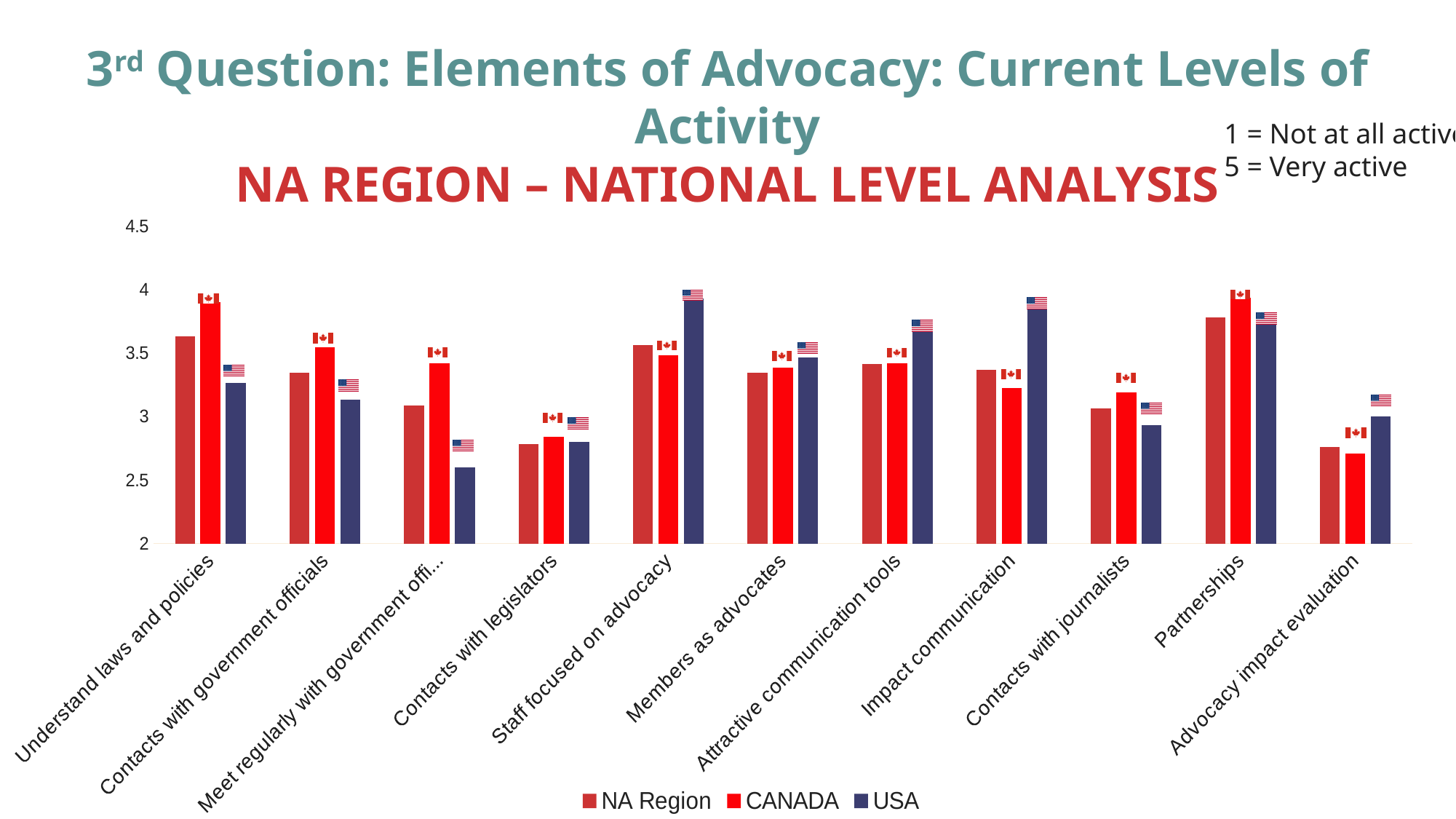
For Impact communication, which is larger: the USA value or the CANADA value? USA How many series does the legend list? 3 Is the USA value for Staff focused on advocacy greater or less than 3.5? greater For Understand laws and policies, which is larger: the CANADA value or the USA value? CANADA Which category has the lowest value for the USA series? Meet regularly with government offi... Is the CANADA value for Understand laws and policies greater or less than 3.5? greater What kind of chart is shown on the slide? bar chart Which category has the highest value for the NA Region series? Partnerships Is the USA value for Meet regularly with government officials greater or less than 3? less What are the three series listed in the legend? NA Region, CANADA, USA Which category has the lowest value for the CANADA series? Advocacy impact evaluation How many categories are shown on the x axis? 11